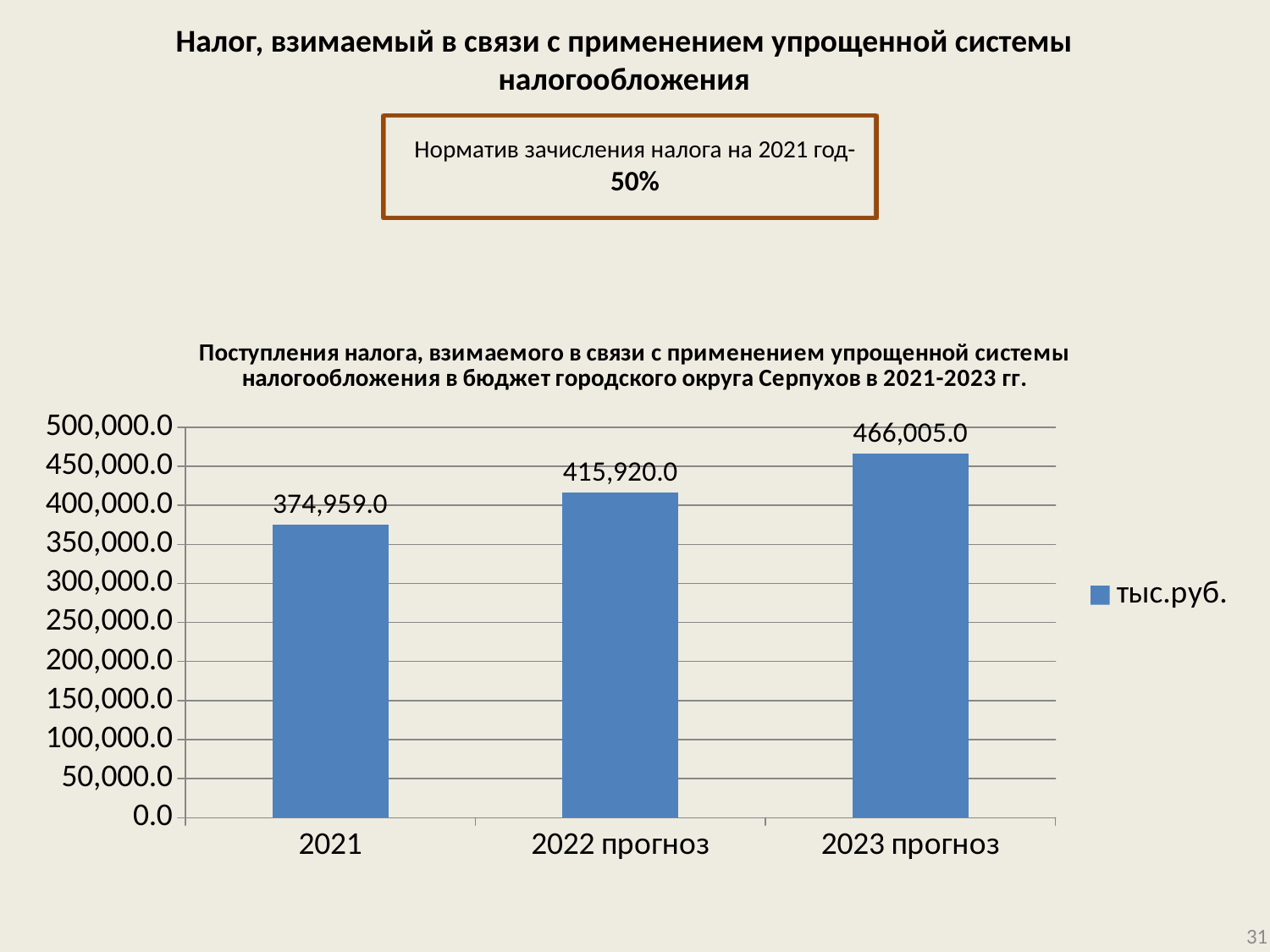
Which is larger, the value for 2021 or the value for 2022 прогноз? 2022 прогноз How many categories are shown on the x axis? 3 What is the value for 2023 прогноз? 466,005.0 What is the value for 2021? 374,959.0 Which category has the lowest value? 2021 What kind of chart is shown on the slide? bar chart Is the value for 2021 greater or less than 400,000.0? less Do the values rise or fall from 2021 to 2023 прогноз? rise What is the value for 2022 прогноз? 415,920.0 Which category has the highest value? 2023 прогноз What is the difference between the values for 2022 прогноз and 2021? 40,961.0 What is the difference between the values for 2023 прогноз and 2022 прогноз? 50,085.0